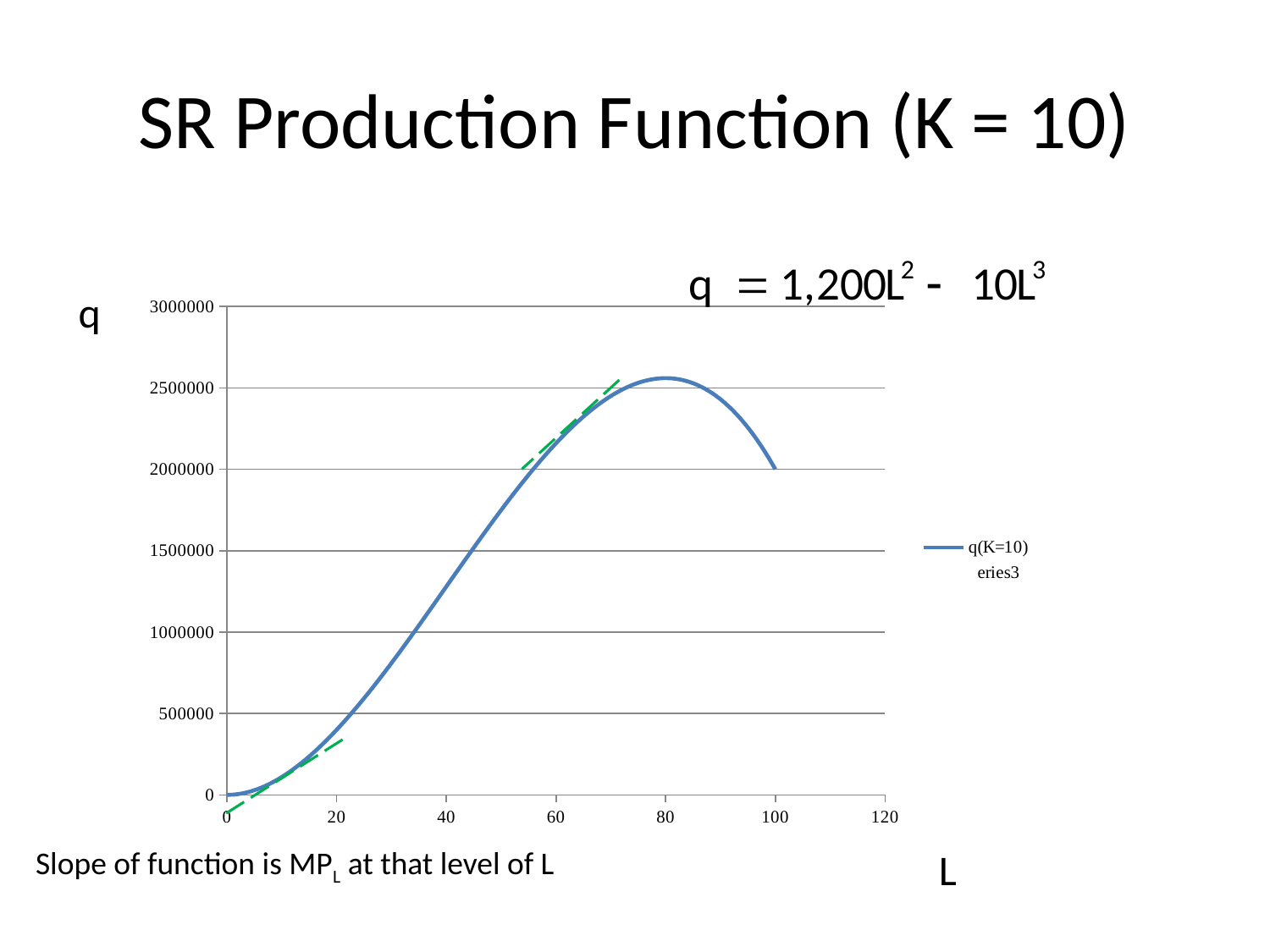
What kind of chart is shown on the slide? line chart What is the value of q where the curve ends at L = 100? 2000000 Is the value of q at L = 20 greater or less than 500000? less Is the value of q at L = 60 greater or less than 2000000? greater What equation is printed above the chart? q = 1,200L² - 10L³ Is the value of q at L = 40 greater or less than 1000000? greater Which is larger, q at L = 60 or q at L = 100? q at L = 60 At which labelled L value on the x axis does the curve reach its highest point? 80 Does q rise or fall as L increases from 80 to 100? fall What is the title of the chart on the slide? SR Production Function (K = 10) What is the value of q at L = 0? 0